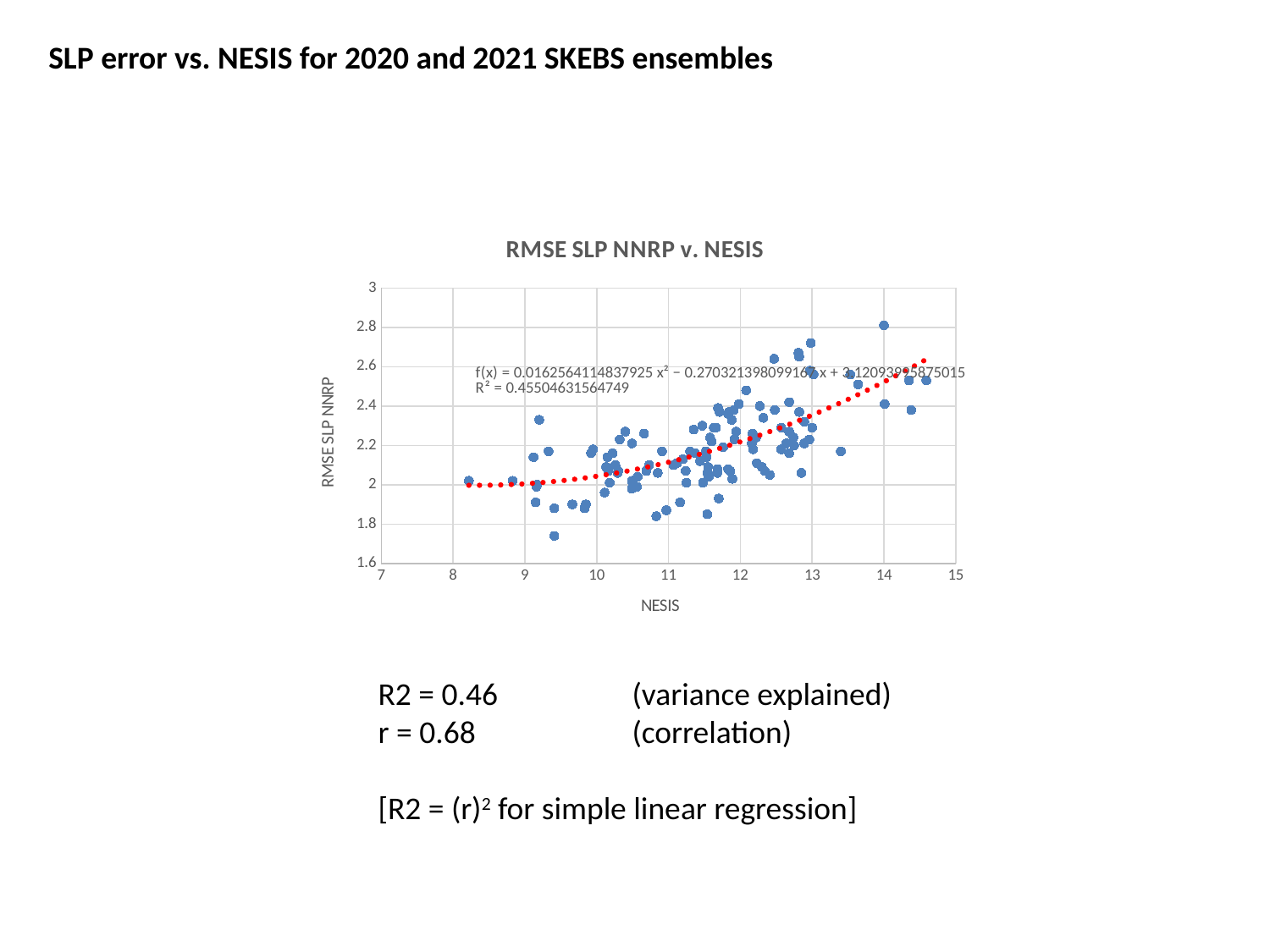
What is the label on the x axis of the chart? NESIS Is the lowest RMSE SLP NNRP value plotted greater or less than 1.8? less What kind of chart is shown on the slide? scatter chart What is the title of the chart? RMSE SLP NNRP v. NESIS Is the highest RMSE SLP NNRP value plotted greater or less than 2.6? greater Is the RMSE SLP NNRP value of the point at NESIS 13.4 greater or less than 2.4? less Do the RMSE SLP NNRP values generally rise or fall as NESIS increases? rise What is the highest value shown on the x axis of the chart? 15 What is the lowest value shown on the y axis of the chart? 1.6 What R² value is printed on the chart next to the trendline equation? 0.45504631564749